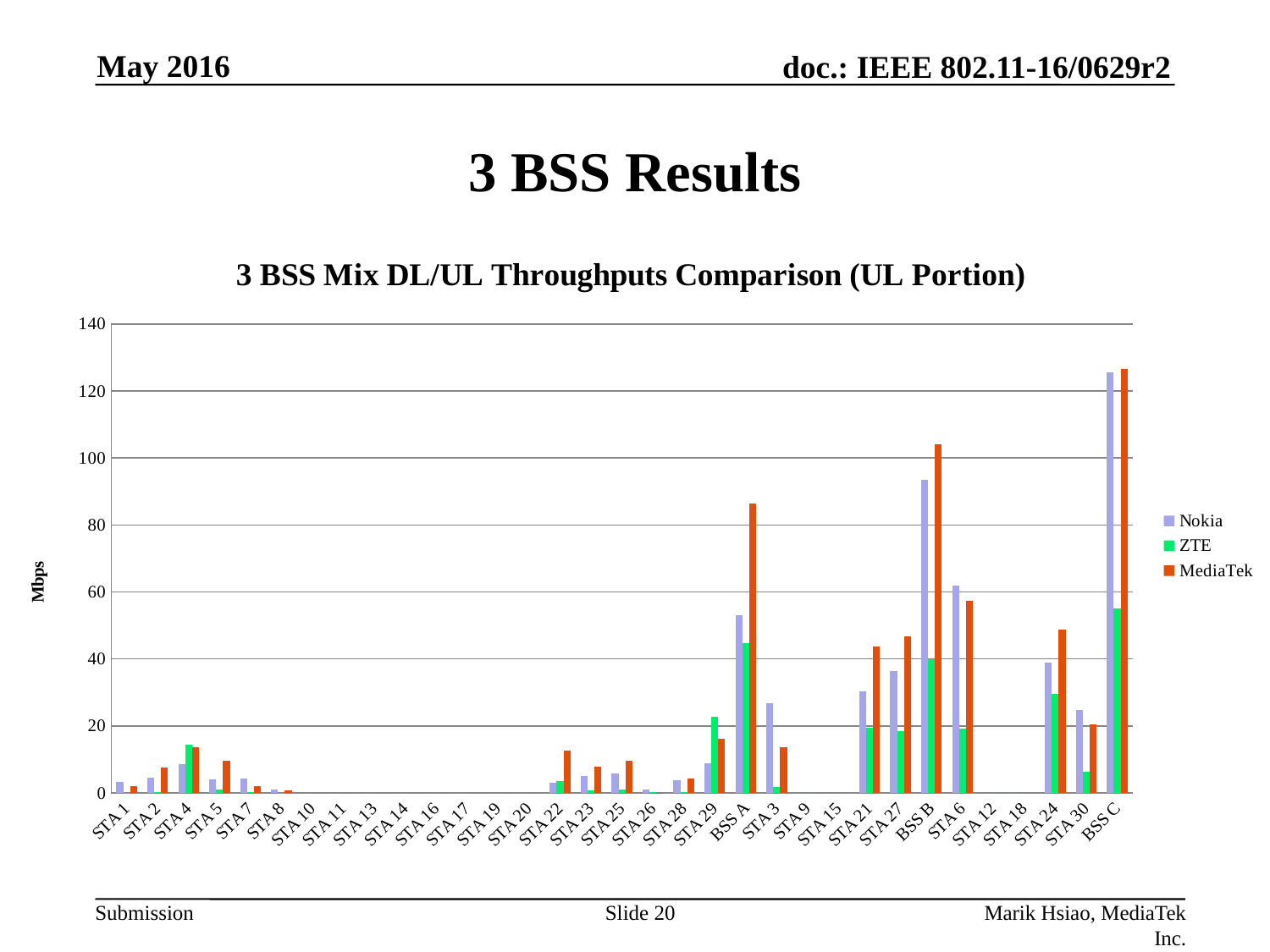
For STA 24, which is larger: the MediaTek value or the Nokia value? MediaTek Which category has the highest Nokia value? BSS C For BSS B, which is larger: the Nokia value or the ZTE value? Nokia What kind of chart is shown on the slide? Bar chart Is the MediaTek value for BSS B greater or less than 100? greater How many series does the legend list? 3 What is the label on the vertical axis? Mbps How many categories are shown on the x axis? 33 Is the MediaTek value for BSS A greater or less than 80? greater What is the title of the chart? 3 BSS Mix DL/UL Throughputs Comparison (UL Portion) Is the Nokia value for BSS B greater or less than 100? less Which category has the highest MediaTek value? BSS C